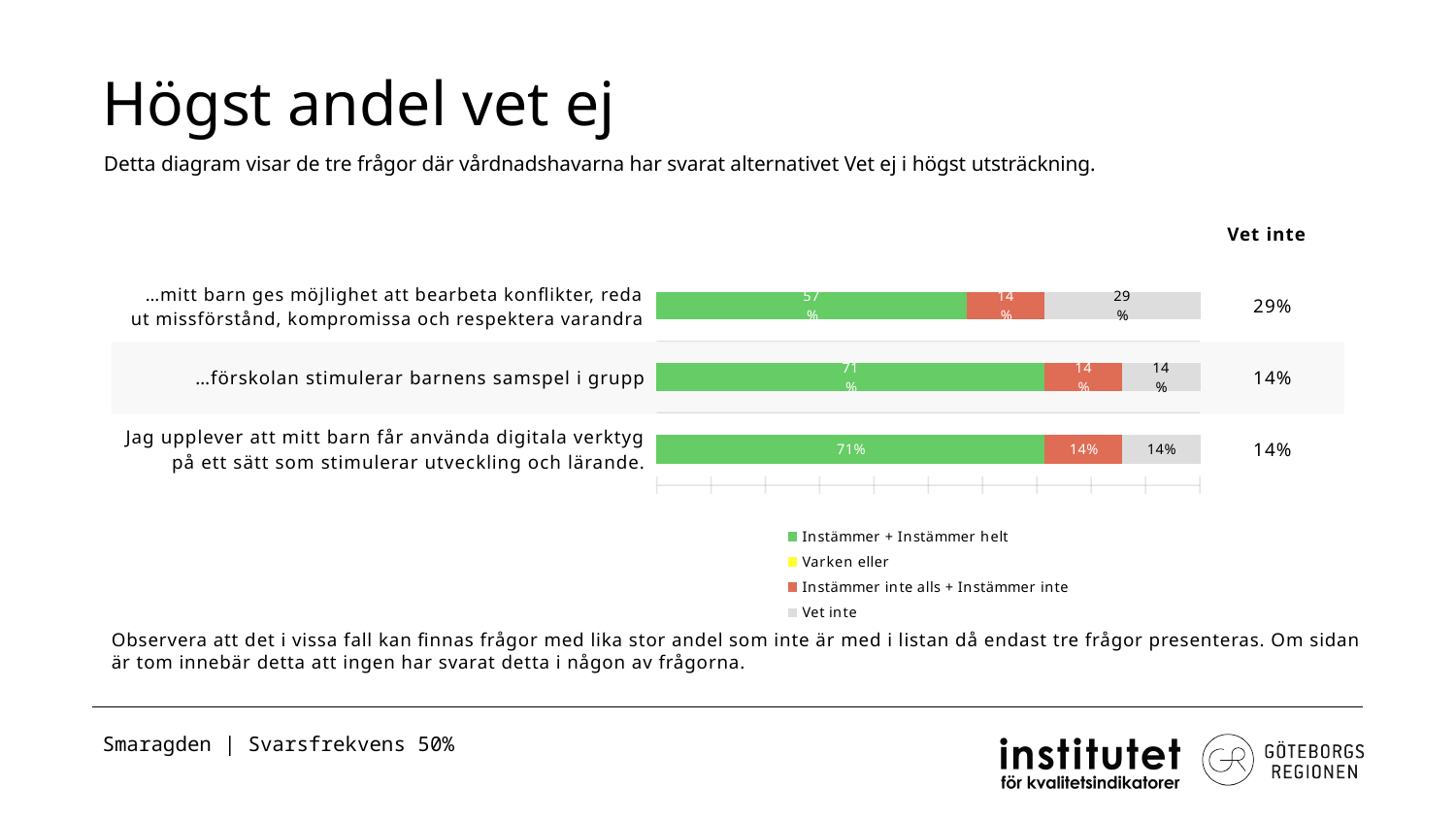
Which category has the highest 'Vet inte' share? …mitt barn ges möjlighet att bearbeta konflikter, reda ut missförstånd, kompromissa och respektera varandra How many categories (questions) are plotted in the chart? 3 What is the difference between the 'Vet inte' value for '…mitt barn ges möjlighet att bearbeta konflikter…' and for '…förskolan stimulerar barnens samspel i grupp'? 15% What is the 'Instämmer + Instämmer helt' value for '…förskolan stimulerar barnens samspel i grupp'? 71% What is the total of the stacked bar for '…mitt barn ges möjlighet att bearbeta konflikter, reda ut missförstånd, kompromissa och respektera varandra'? 100% Which is larger: the 'Instämmer + Instämmer helt' value for '…förskolan stimulerar barnens samspel i grupp' or for '…mitt barn ges möjlighet att bearbeta konflikter…'? …förskolan stimulerar barnens samspel i grupp How many series does the chart legend list? 4 What kind of chart is shown on the slide? stacked bar chart What is the 'Vet inte' value for '…mitt barn ges möjlighet att bearbeta konflikter, reda ut missförstånd, kompromissa och respektera varandra'? 29% Which category has the lowest 'Instämmer + Instämmer helt' share? …mitt barn ges möjlighet att bearbeta konflikter, reda ut missförstånd, kompromissa och respektera varandra What is the 'Instämmer inte alls + Instämmer inte' value for 'Jag upplever att mitt barn får använda digitala verktyg på ett sätt som stimulerar utveckling och lärande'? 14% Which legend entry is shown in grey? Vet inte